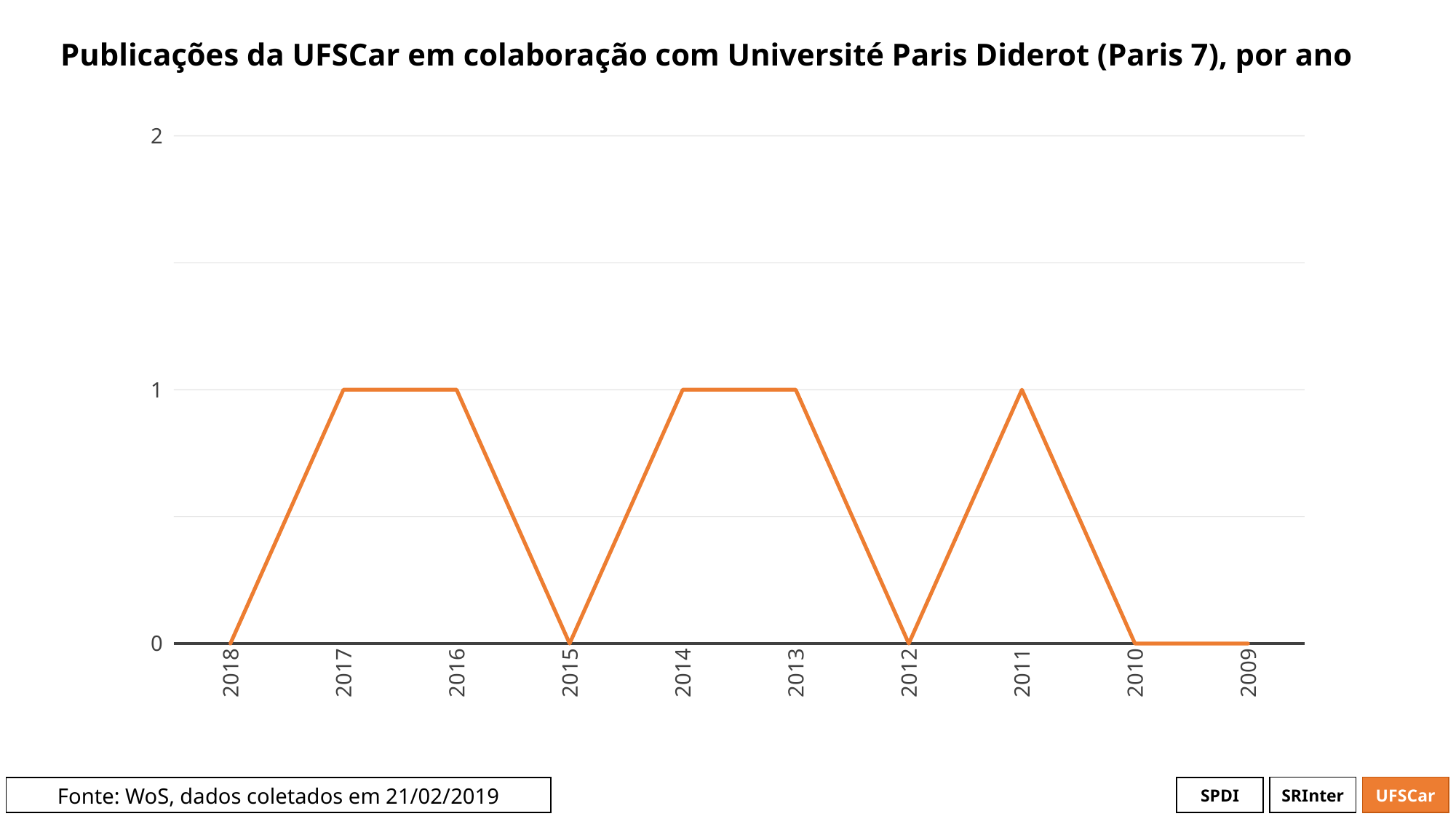
How many years are plotted on the x axis? 10 Which is larger, the value for 2014 or the value for 2012? 2014 What is the value for 2017? 1 What is the value for 2011? 1 What is the highest value reached by the line? 1 What is the title of the chart? Publicações da UFSCar em colaboração com Université Paris Diderot (Paris 7), por ano What is the difference between the value for 2013 and the value for 2010? 1 What colour is the plotted line? orange What is the value for 2009? 0 What kind of chart is shown on the slide? line chart What is the value for 2015? 0 Is the value for 2016 greater or less than 2? less